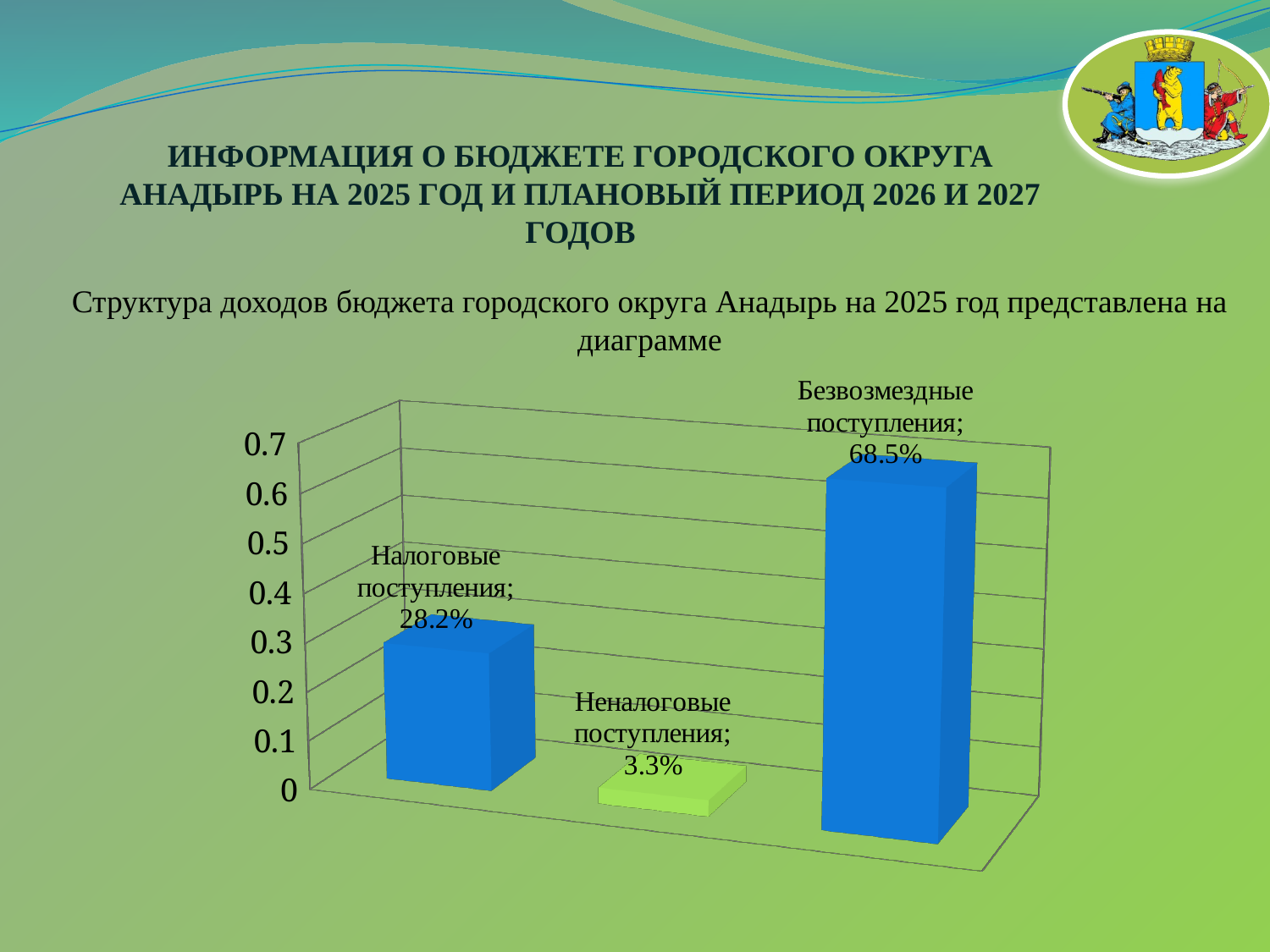
How many categories are shown in the chart? 3 What is the value for Неналоговые поступления? 3.3% What is the difference between Безвозмездные поступления and Налоговые поступления? 40.3% What is the difference between Налоговые поступления and Неналоговые поступления? 24.9% Is the value for Безвозмездные поступления greater or less than 0.6? greater What kind of chart is shown on the slide? bar chart What is the value for Безвозмездные поступления? 68.5% What is the highest value shown on the vertical axis? 0.7 Which category has the lowest value? Неналоговые поступления What is the value for Налоговые поступления? 28.2% Which is larger, Налоговые поступления or Неналоговые поступления? Налоговые поступления Which category has the highest value? Безвозмездные поступления